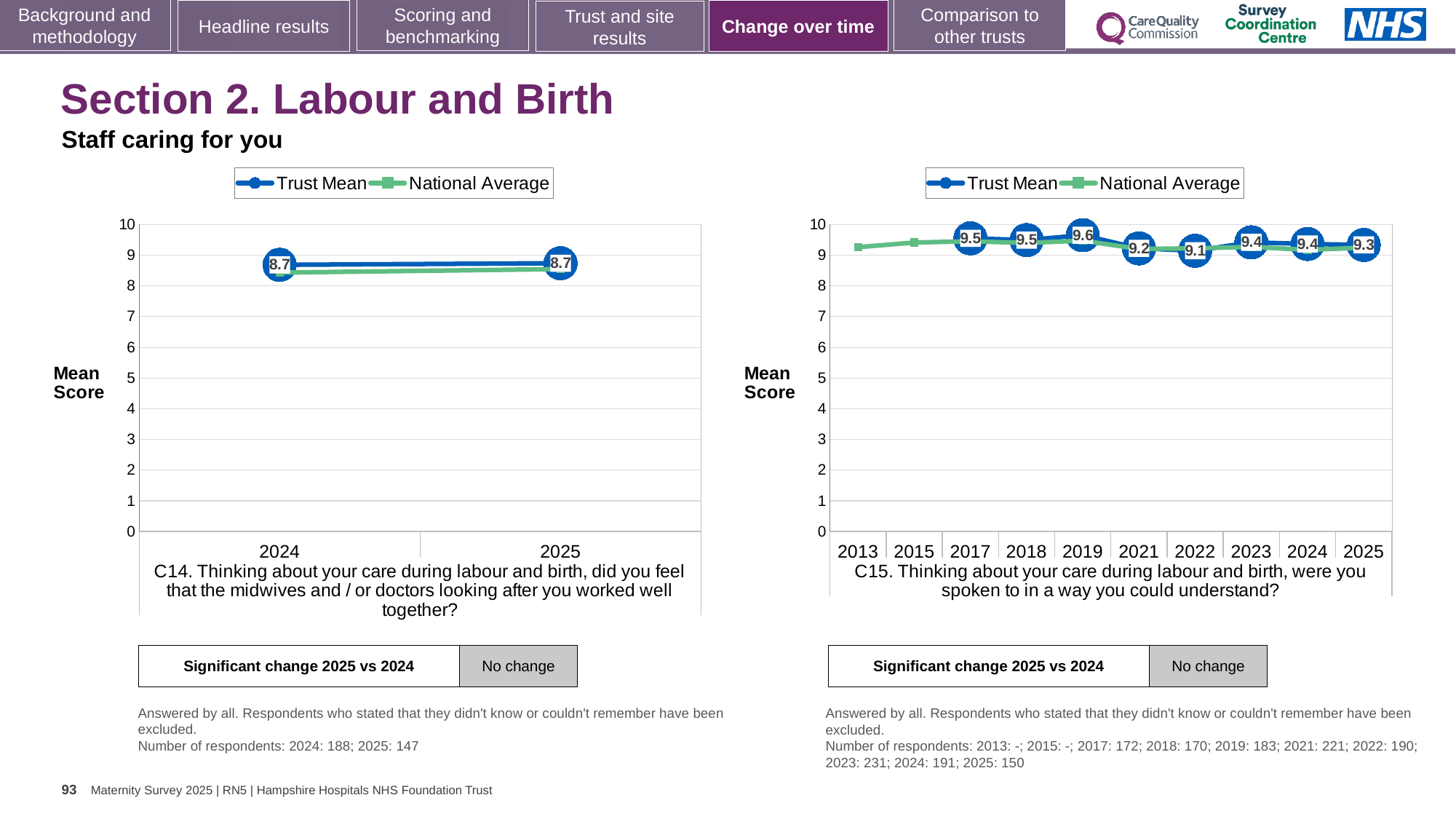
How many years are shown on the x axis of the right chart (C15)? 10 In the right chart (C15), what is the Trust Mean score for 2019? 9.6 In the right chart (C15), is the National Average value for 2013 greater or less than 9? greater In the right chart (C15), what is the Trust Mean score for 2022? 9.1 How many series does the legend of the left chart (C14) list? 2 What type of chart is the right chart (C15)? Line chart In the right chart (C15), which year has the lowest Trust Mean score? 2022 In the right chart (C15), what is the difference between the Trust Mean scores for 2019 and 2022? 0.5 In the left chart (C14), what is the Trust Mean score for 2024? 8.7 In the right chart (C15), which year has the highest Trust Mean score? 2019 In the left chart (C14), what is the Trust Mean score for 2025? 8.7 In the right chart (C15), is the Trust Mean score higher in 2023 or in 2025? 2023